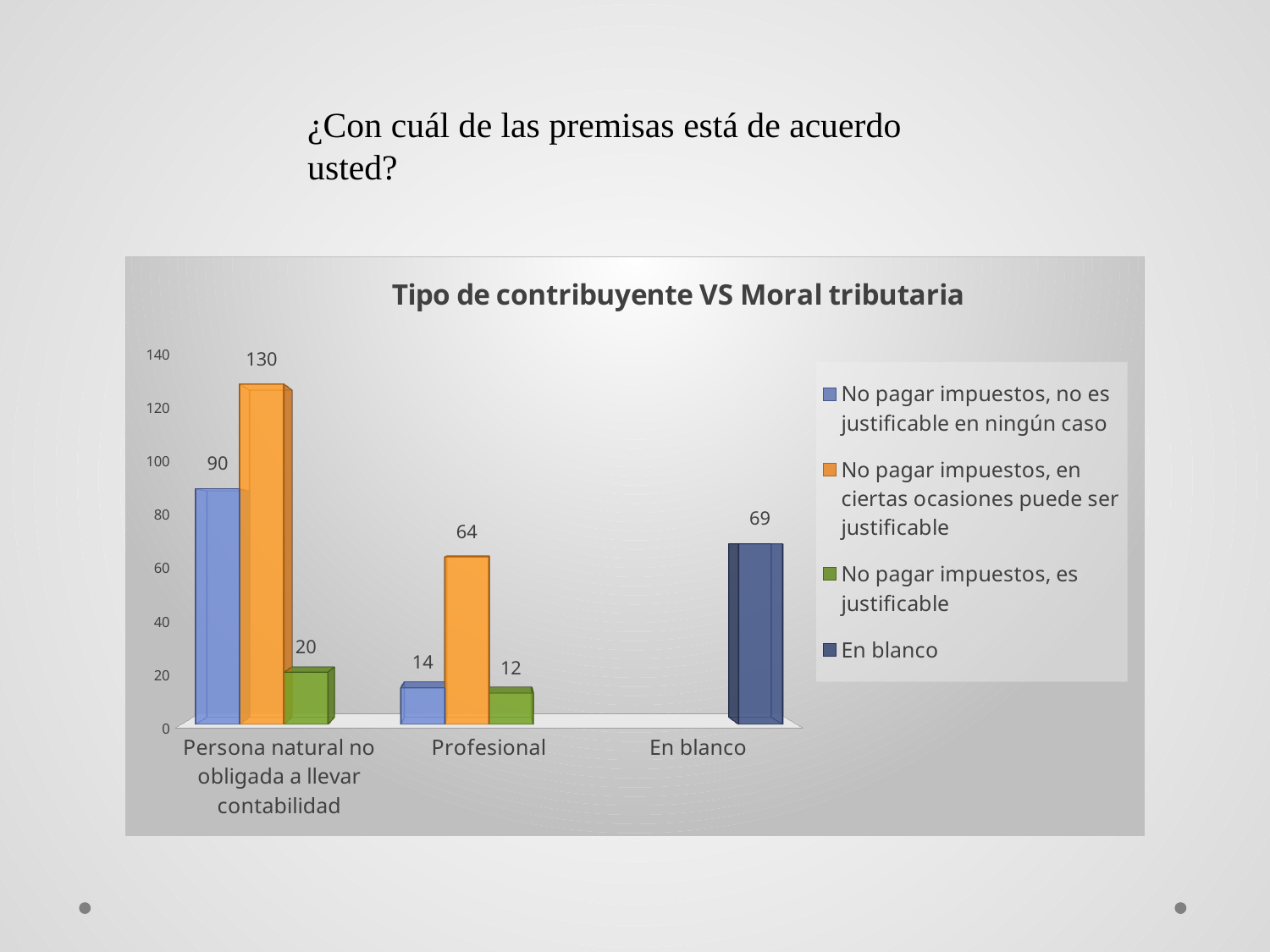
What is the value for 'No pagar impuestos, en ciertas ocasiones puede ser justificable' in the 'Persona natural no obligada a llevar contabilidad' category? 130 What is the value for 'No pagar impuestos, no es justificable en ningún caso' in the 'Profesional' category? 14 What kind of chart is shown on the slide? Bar chart What is the value of the 'En blanco' series in the 'En blanco' category? 69 Which category has the highest single bar in the chart? Persona natural no obligada a llevar contabilidad What is the difference between the 'No pagar impuestos, en ciertas ocasiones puede ser justificable' values for 'Persona natural no obligada a llevar contabilidad' and 'Profesional'? 66 Which is larger: the 'No pagar impuestos, no es justificable en ningún caso' value for 'Persona natural no obligada a llevar contabilidad' or the 'En blanco' value for 'En blanco'? Persona natural no obligada a llevar contabilidad How many series does the legend list? 4 What is the title of the chart? Tipo de contribuyente VS Moral tributaria What is the value for 'No pagar impuestos, es justificable' in the 'Persona natural no obligada a llevar contabilidad' category? 20 How many categories are shown on the x axis? 3 Which series has the lowest value in the 'Profesional' category? No pagar impuestos, es justificable